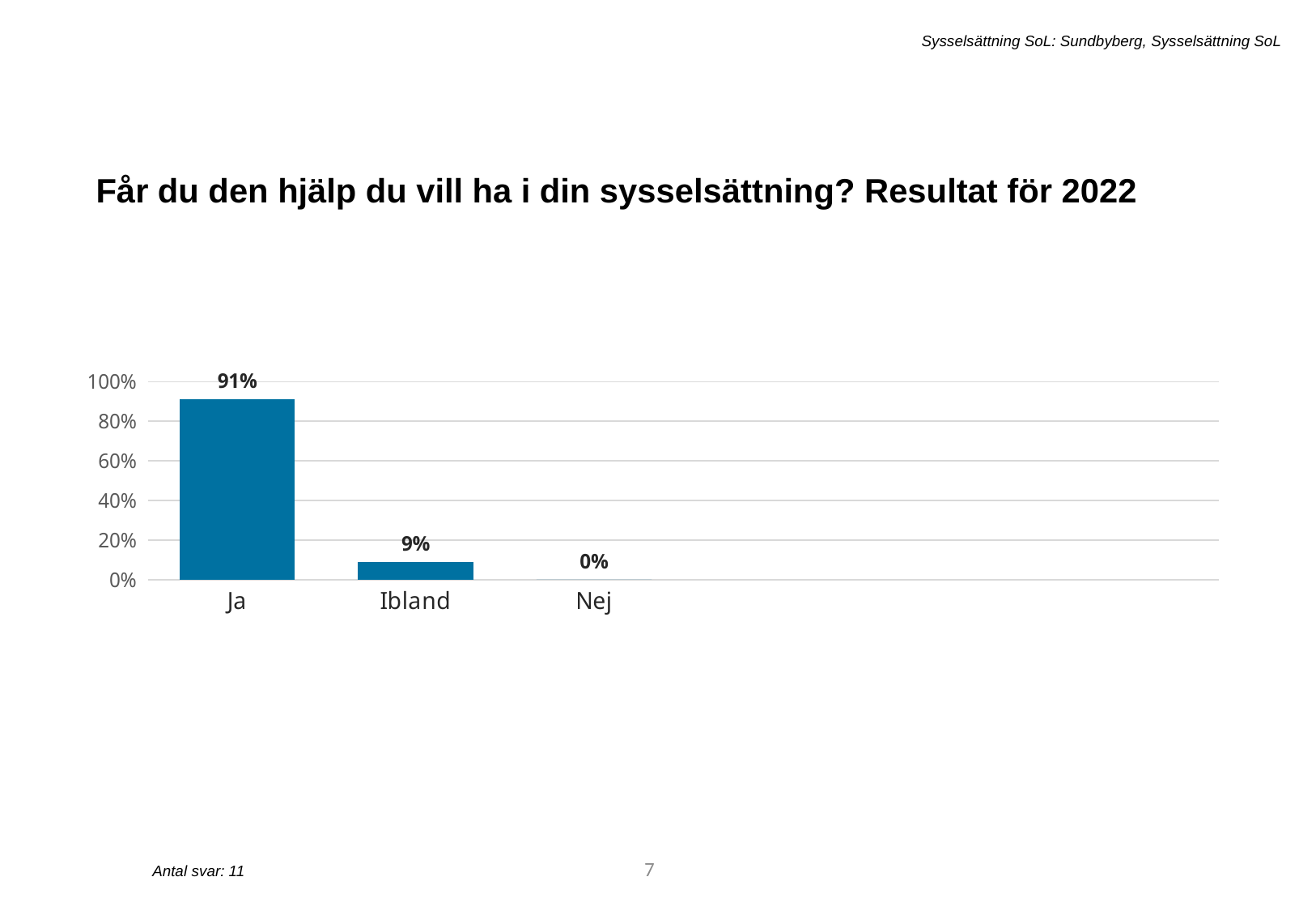
What is the value for Ibland? 9% Is the value for Ibland greater or less than 20%? less Which is larger, the value for Ibland or the value for Nej? Ibland How many categories are shown on the x axis? 3 Which category has the lowest value? Nej What is the title of the slide? Får du den hjälp du vill ha i din sysselsättning? Resultat för 2022 Which category has the highest value? Ja What is the difference between the values for Ja and Ibland? 82% What kind of chart is shown on the slide? bar chart Is the value for Ja greater or less than 80%? greater What is the value for Ja? 91% What is the value for Nej? 0%